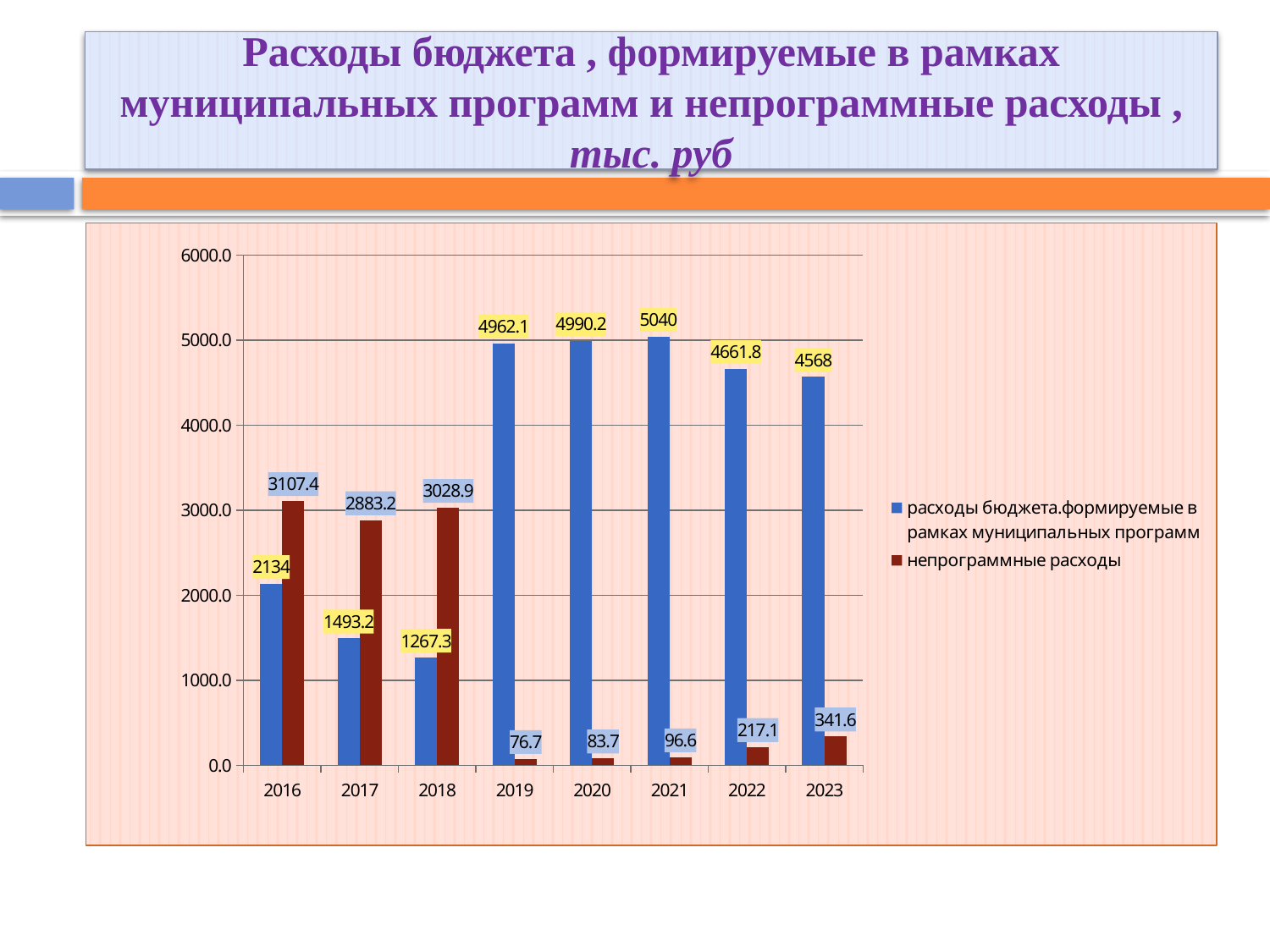
What is the value of расходы бюджета, формируемые в рамках муниципальных программ for 2018? 1267.3 What is the value of непрограммные расходы for 2019? 76.7 Which is larger in 2017: расходы бюджета, формируемые в рамках муниципальных программ or непрограммные расходы? непрограммные расходы What is the difference between непрограммные расходы in 2023 and in 2022? 124.5 Do the values of непрограммные расходы rise or fall from 2019 to 2023? rise What is the value of расходы бюджета, формируемые в рамках муниципальных программ for 2021? 5040 How many years are shown on the x axis? 8 In which year is the value of расходы бюджета, формируемые в рамках муниципальных программ the lowest? 2018 How many series does the legend list? 2 In which year is the value of непрограммные расходы the highest? 2016 What kind of chart is shown on the slide? bar chart What is the value of непрограммные расходы for 2016? 3107.4